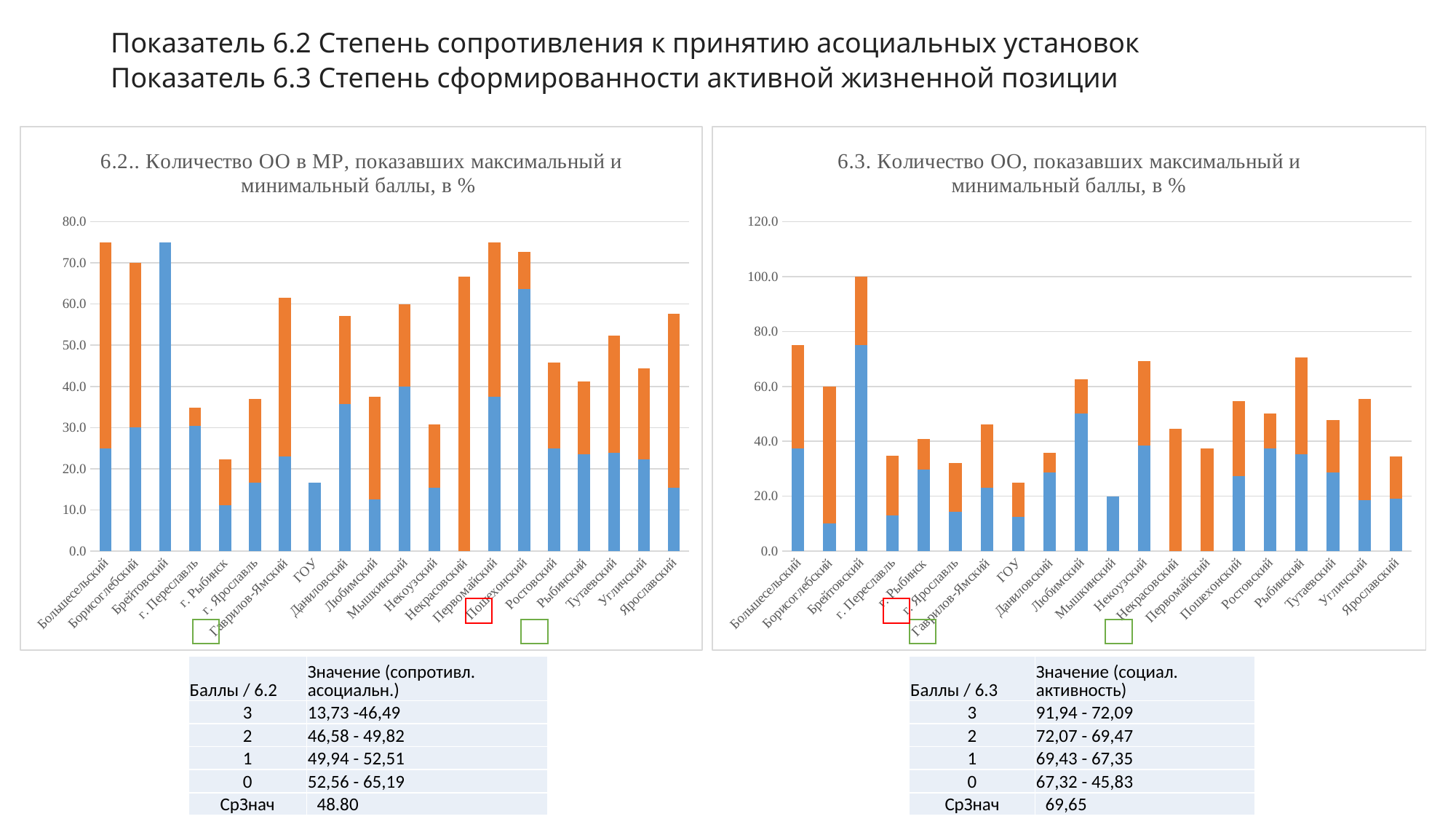
In the left chart (6.2), is the total value for ГОУ greater or less than 20? less In the left chart (6.2), which category has the lowest total bar? ГОУ In the right chart (6.3), which category has the highest total bar? Брейтовский In the left chart (6.2), how many categories are shown on the x axis? 20 In the right chart (6.3), is the total value for Мышкинский greater or less than 40? less In the right chart (6.3), how many categories are shown on the x axis? 20 In the right chart (6.3), is the total value for Брейтовский greater or less than 80? greater What is the highest tick value shown on the y axis of the right chart (6.3)? 120.0 What kind of chart is the left chart titled "6.2.. Количество ОО в МР, показавших максимальный и минимальный баллы, в %"? bar chart In the left chart (6.2), which has the larger total bar, Даниловский or Любимский? Даниловский In the right chart (6.3), which category has the lowest total bar? Мышкинский